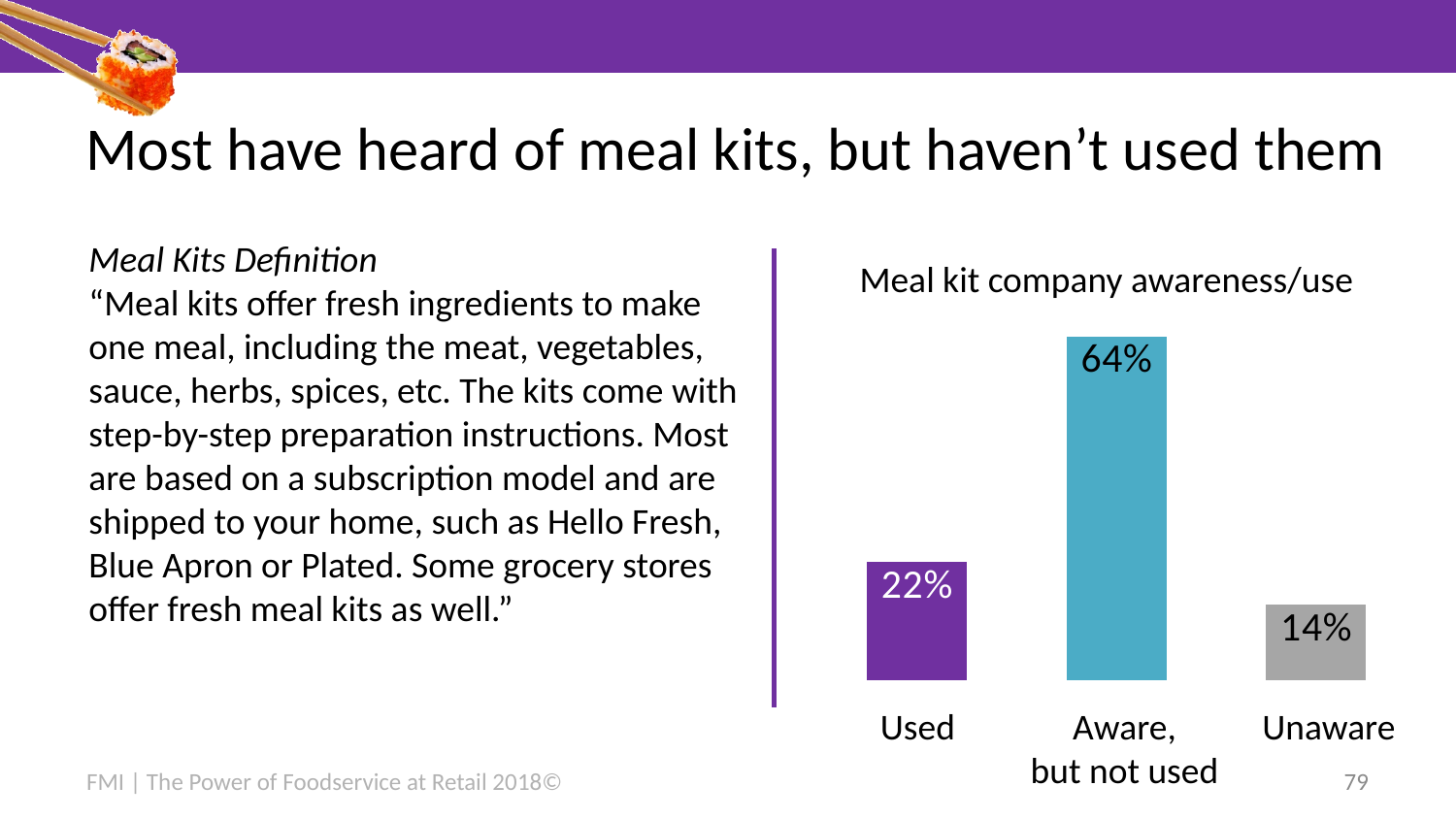
Which category has the highest value? Aware, but not used What percentage of respondents are unaware of meal kit companies? 14% What is the title of the chart? Meal kit company awareness/use What is the difference between the 'Used' and 'Unaware' values? 8 percentage points What is the difference between the 'Aware, but not used' and 'Used' values? 42 percentage points What percentage of respondents have used a meal kit company? 22% How many categories are shown in the chart? 3 Which is larger, the value for 'Used' or the value for 'Unaware'? Used What kind of chart is shown on the slide? Bar chart What colour is the bar for 'Aware, but not used'? Blue What is the value for 'Aware, but not used'? 64% Which category has the lowest value? Unaware